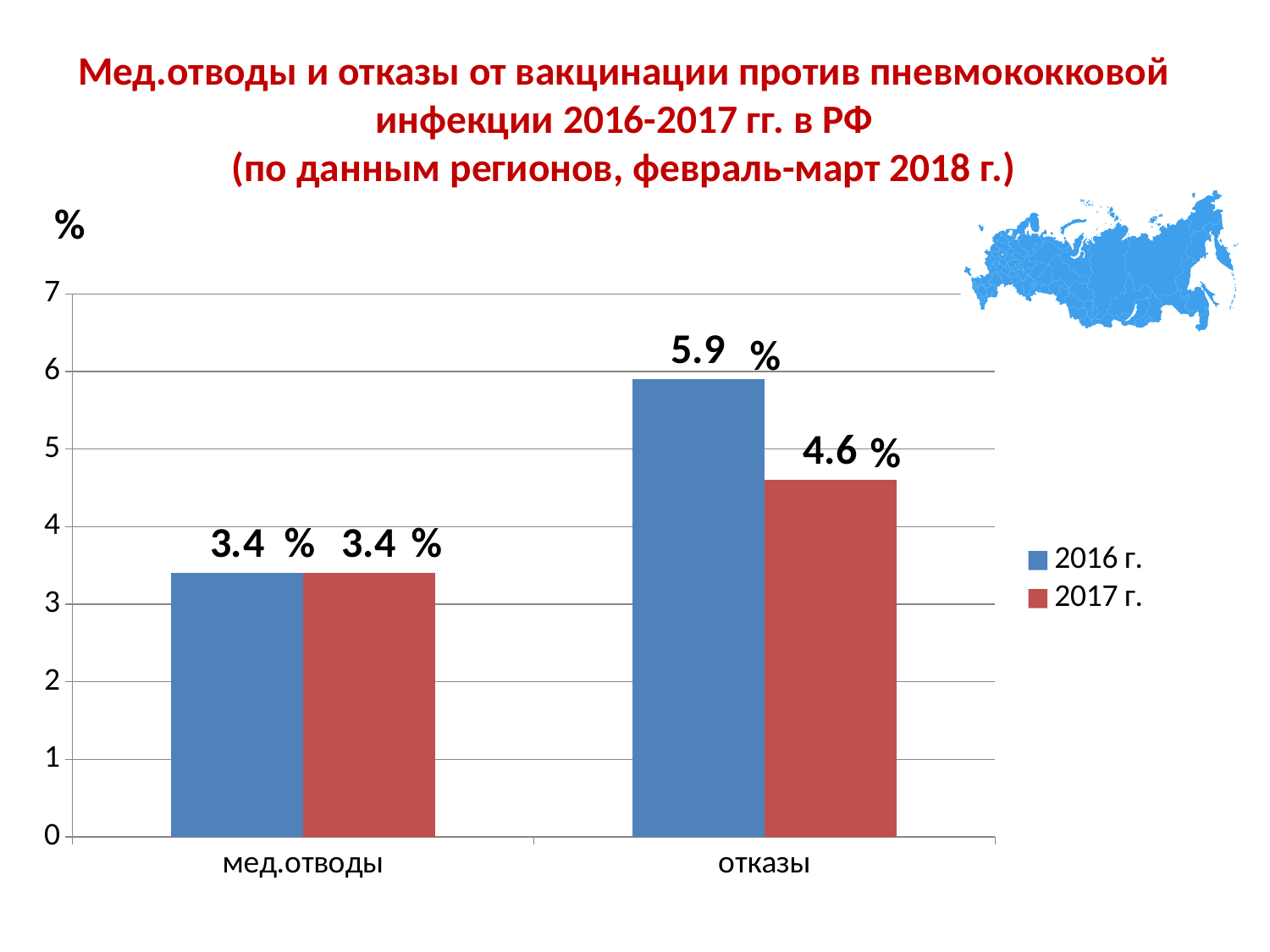
What is the value for мед.отводы in 2016 г.? 3.4 % Is the value for отказы in 2016 г. greater or less than 5? greater How many series does the legend list? 2 Which category has the highest value for 2016 г.? отказы Which colour represents 2017 г. in the legend? red Which category has the lowest value for 2017 г.? мед.отводы How many categories are shown on the x axis? 2 What is the value for отказы in 2017 г.? 4.6 % Which is larger for отказы: the 2016 г. value or the 2017 г. value? 2016 г. What is the difference between the 2016 г. and 2017 г. values for отказы? 1.3 % What kind of chart is shown on the slide? bar chart What is the value for отказы in 2016 г.? 5.9 %